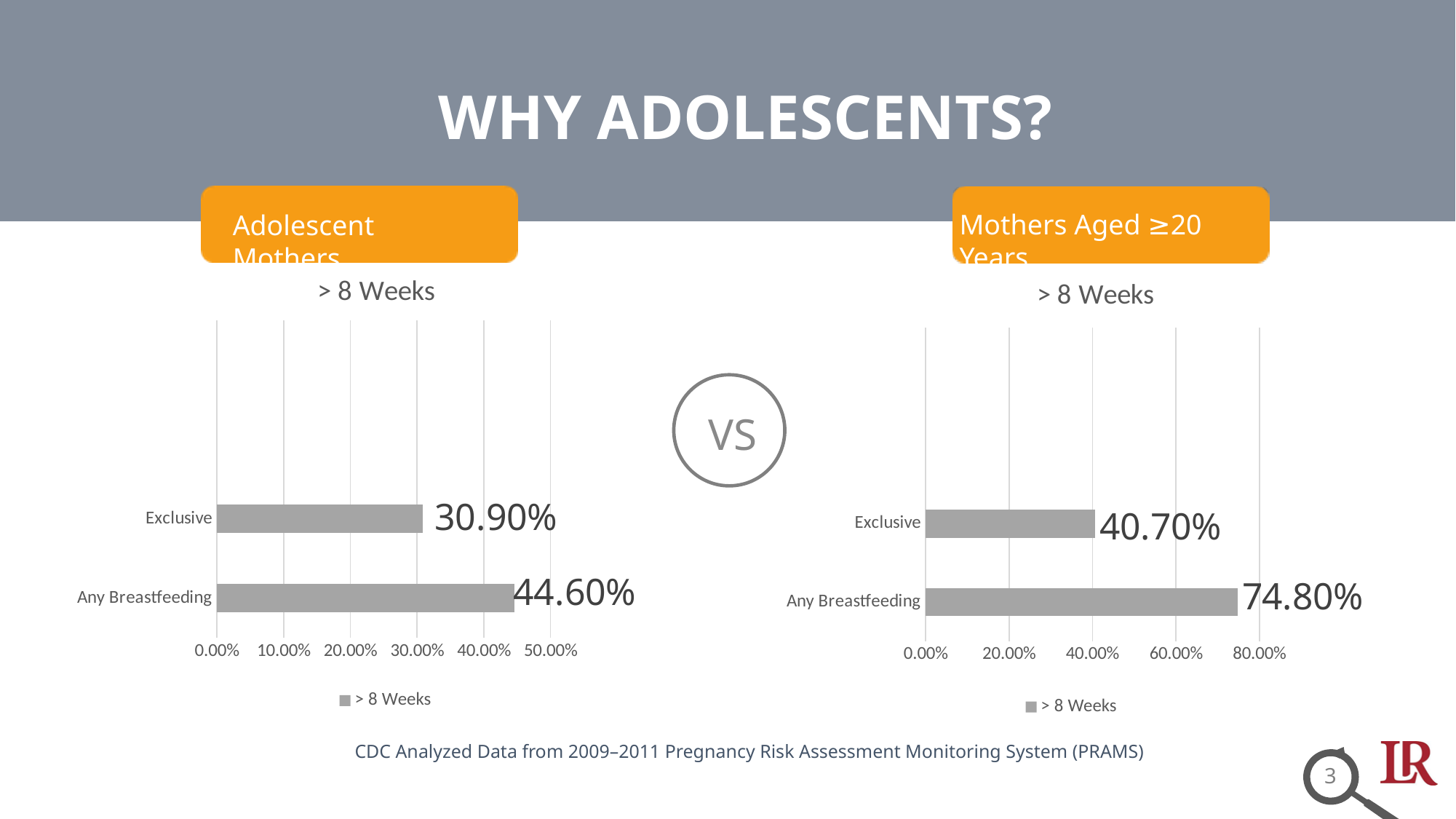
Which is larger: the Exclusive value in the left chart (Adolescent Mothers) or the Exclusive value in the right chart (Mothers Aged ≥20 Years)? Mothers Aged ≥20 Years What kind of chart is the right chart (Mothers Aged ≥20 Years)? bar chart In the right chart (Mothers Aged ≥20 Years), what is the value for Exclusive? 40.70% In the left chart (Adolescent Mothers), what is the difference between Any Breastfeeding and Exclusive? 13.70% In the right chart (Mothers Aged ≥20 Years), what is the difference between Any Breastfeeding and Exclusive? 34.10% In the right chart (Mothers Aged ≥20 Years), is the value for Any Breastfeeding greater or less than 60.00%? greater In the right chart (Mothers Aged ≥20 Years), what is the value for Any Breastfeeding? 74.80% In the left chart (Adolescent Mothers), what is the value for Exclusive? 30.90% In the right chart (Mothers Aged ≥20 Years), which category has the lowest value? Exclusive In the left chart (Adolescent Mothers), which category has the highest value? Any Breastfeeding In the left chart (Adolescent Mothers), what is the value for Any Breastfeeding? 44.60% How many categories are shown in the left chart (Adolescent Mothers)? 2